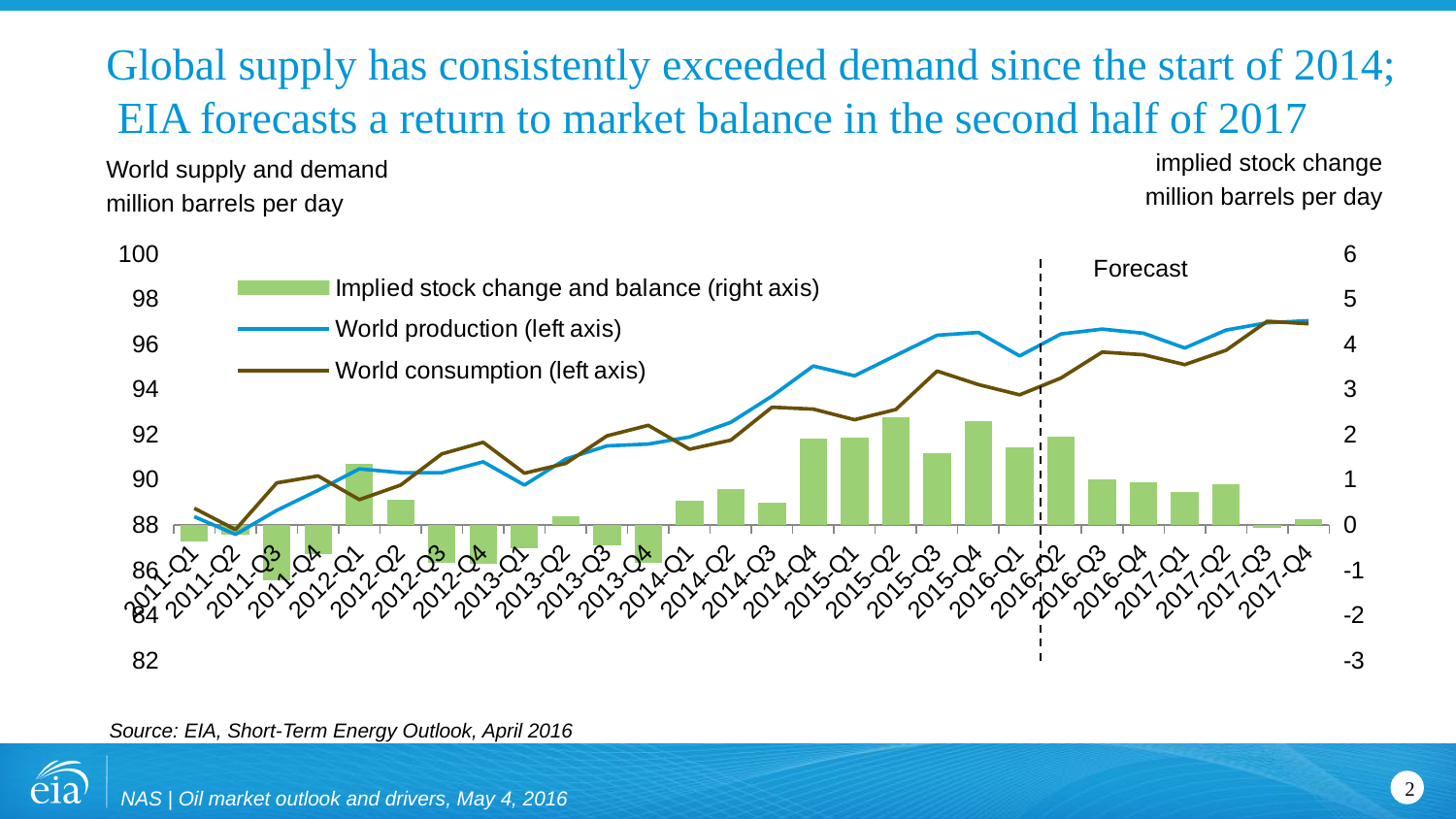
Which quarter has the lowest implied stock change bar? 2011-Q3 Is world consumption in 2011-Q1 greater or less than 90 million barrels per day? less In 2015-Q2, which is higher: world production or world consumption? World production Is world production in 2017-Q4 greater or less than 96 million barrels per day? greater Is the implied stock change bar for 2011-Q3 greater or less than 0? less From which quarter does the forecast period begin, as marked by the dashed line? 2016-Q2 What type of chart is shown on the slide? Combined bar and line chart Which series is plotted on the right axis according to the legend? Implied stock change and balance Does world production generally rise or fall from 2011-Q1 to 2017-Q4? Rise How many quarters are shown along the x axis of the chart? 28 How many series does the chart legend list? 3